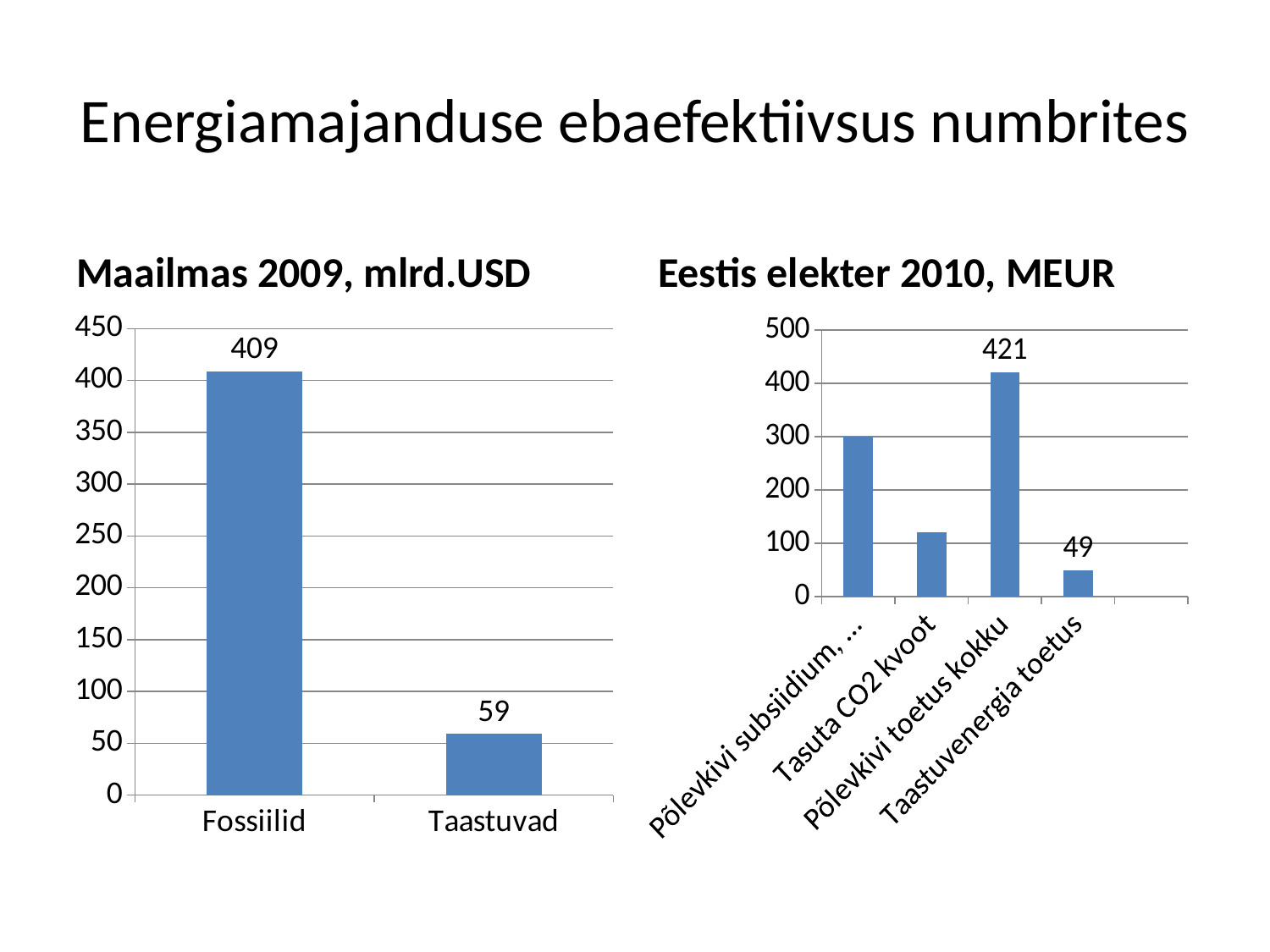
In the chart titled 'Eestis elekter 2010, MEUR', what is the value for Põlevkivi toetus kokku? 421 What kind of chart is the one titled 'Eestis elekter 2010, MEUR'? Bar chart In the chart titled 'Eestis elekter 2010, MEUR', what is the difference between Põlevkivi toetus kokku and Taastuvenergia toetus? 372 In the chart titled 'Maailmas 2009, mlrd.USD', how many categories are shown? 2 In the chart titled 'Eestis elekter 2010, MEUR', which category has the lowest value? Taastuvenergia toetus In the chart titled 'Maailmas 2009, mlrd.USD', what is the value for Taastuvad? 59 In the chart titled 'Maailmas 2009, mlrd.USD', what is the value for Fossiilid? 409 In the chart titled 'Eestis elekter 2010, MEUR', is the value for Tasuta CO2 kvoot greater or less than 200? less In the chart titled 'Eestis elekter 2010, MEUR', what is the value for Taastuvenergia toetus? 49 In the chart titled 'Maailmas 2009, mlrd.USD', what is the difference between the Fossiilid and Taastuvad values? 350 In the chart titled 'Maailmas 2009, mlrd.USD', which category has the higher value? Fossiilid In the chart titled 'Eestis elekter 2010, MEUR', how many bars are shown? 4